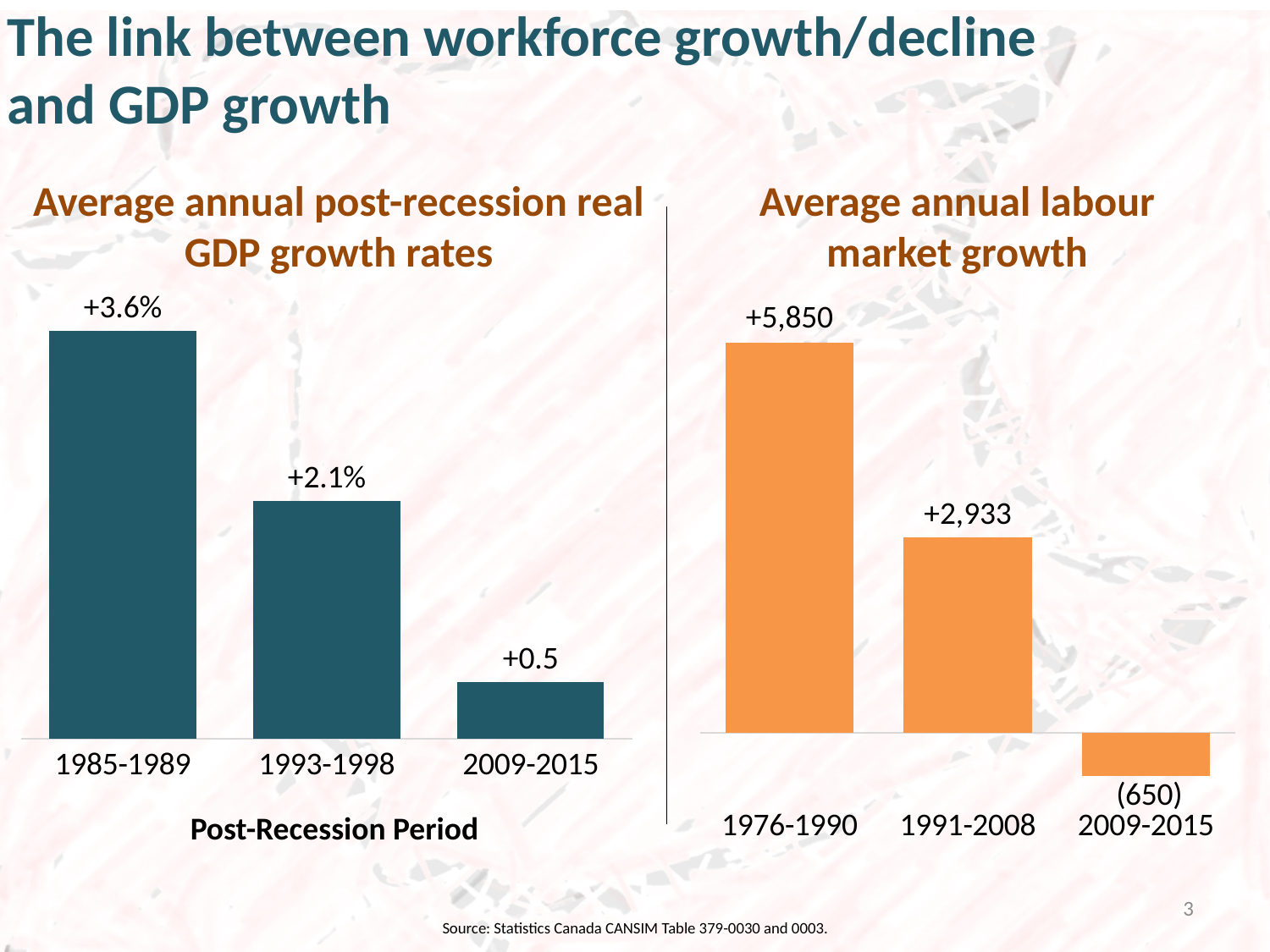
In the 'Average annual labour market growth' chart, which period has the lowest value? 2009-2015 In the 'Average annual labour market growth' chart, what is the value for 1976-1990? +5,850 How many periods are shown in the 'Average annual labour market growth' chart? 3 In the 'Average annual labour market growth' chart, what is the value for 1991-2008? +2,933 In the 'Average annual post-recession real GDP growth rates' chart, what is the value for 2009-2015? +0.5 In the 'Average annual labour market growth' chart, what is the value for 2009-2015? (650) In the 'Average annual post-recession real GDP growth rates' chart, which period has the highest value? 1985-1989 In the 'Average annual labour market growth' chart, what is the difference between the values for 1976-1990 and 1991-2008? 2,917 In the 'Average annual post-recession real GDP growth rates' chart, what is the value for 1993-1998? +2.1% In the 'Average annual post-recession real GDP growth rates' chart, what is the value for 1985-1989? +3.6% In the 'Average annual post-recession real GDP growth rates' chart, do the values rise or fall from left to right? fall What kind of chart is the 'Average annual post-recession real GDP growth rates' chart? bar chart